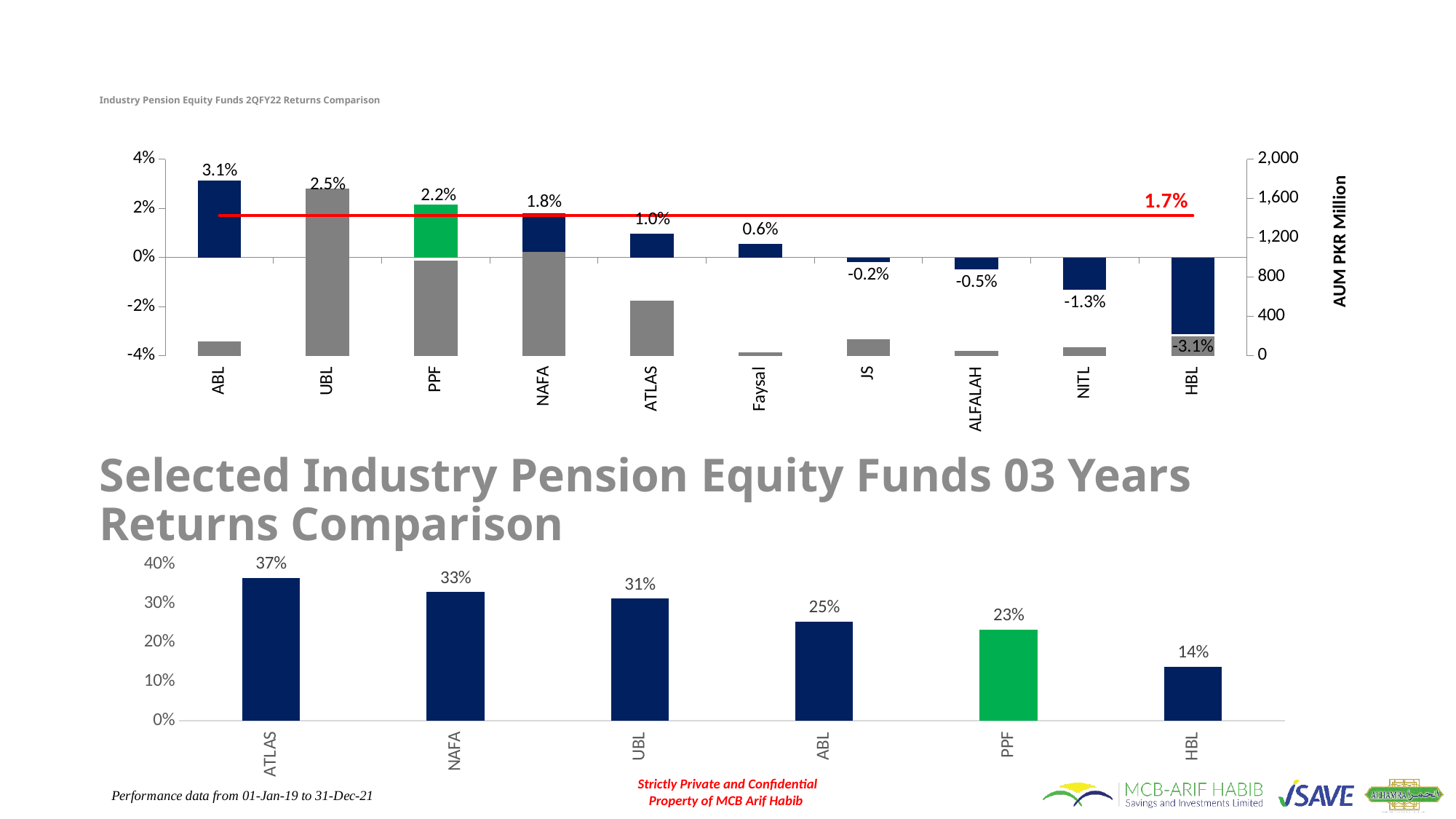
In the bottom chart (03 Years Returns Comparison), what is the difference between the returns of ATLAS and HBL? 23% In the top chart (2QFY22 Returns Comparison), which fund has the lowest return? HBL In the bottom chart (Selected Industry Pension Equity Funds 03 Years Returns Comparison), what is the return shown for PPF? 23% In the top chart (2QFY22 Returns Comparison), what is the difference between the returns of UBL and PPF? 0.3% In the top chart (2QFY22 Returns Comparison), how many funds are shown on the x axis? 10 In the top chart (2QFY22 Returns Comparison), which has the higher return, NAFA or ATLAS? NAFA In the bottom chart (03 Years Returns Comparison), how many funds are shown? 6 In the top chart (2QFY22 Returns Comparison), what value does the red horizontal line mark? 1.7% In the top chart (2QFY22 Returns Comparison), what is the return shown for NITL? -1.3% What type of chart is the bottom chart (03 Years Returns Comparison)? Bar chart In the top chart (Industry Pension Equity Funds 2QFY22 Returns Comparison), what is the return shown for ABL? 3.1% In the bottom chart (03 Years Returns Comparison), which fund has the highest return? ATLAS